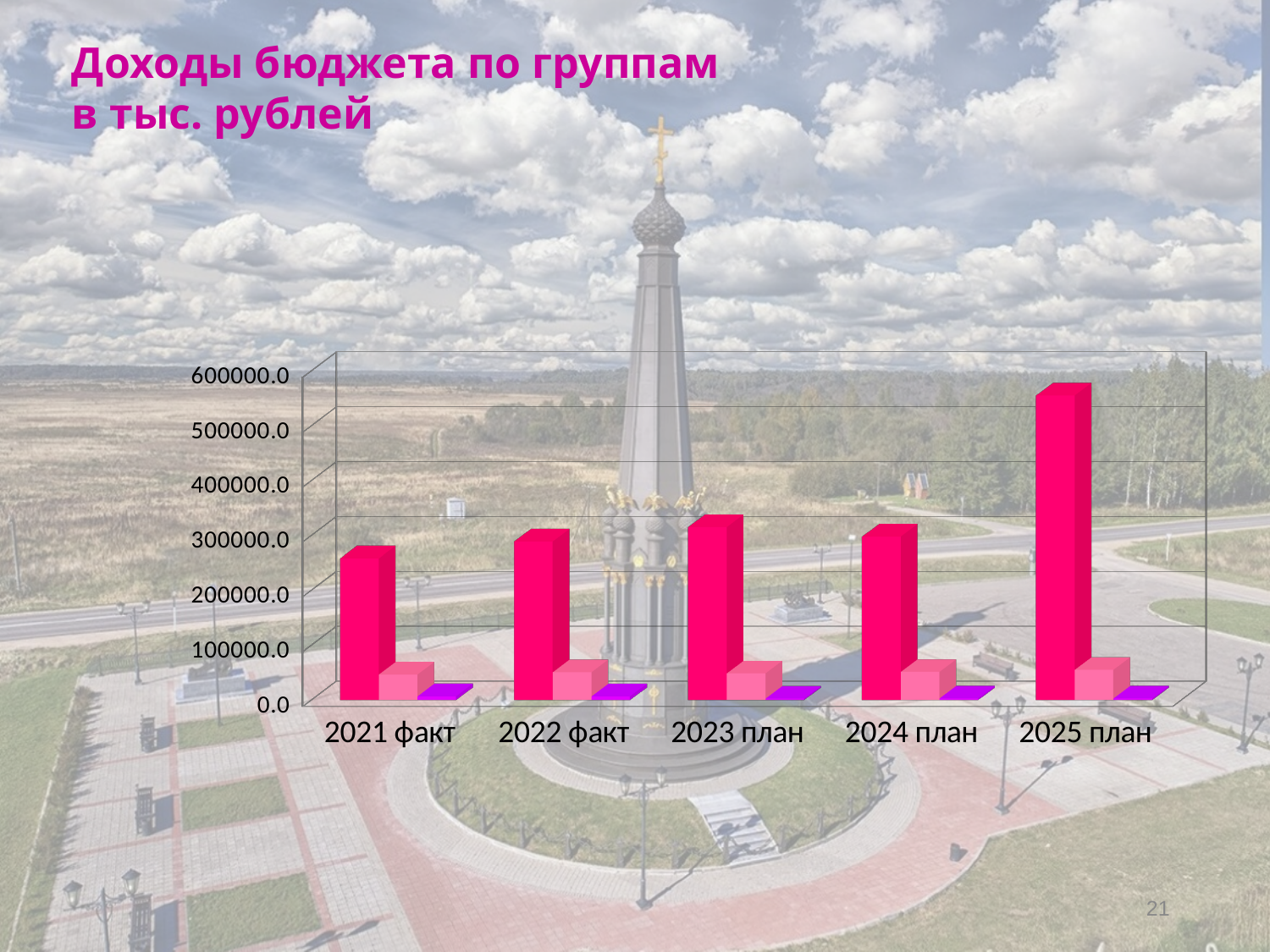
Which category has the tallest bar in the chart? 2025 план Is the tallest bar for 2022 факт greater or less than 200000.0? greater Among the tallest (magenta) bars, which category has the lowest value? 2021 факт What kind of chart is shown on the slide? bar chart Which is larger: the tallest bar for 2025 план or the tallest bar for 2023 план? 2025 план What is the title of the chart on the slide? Доходы бюджета по группам в тыс. рублей How many categories are shown on the x axis of the chart? 5 Is the tallest bar for 2024 план greater or less than 400000.0? less What is the highest value shown on the vertical axis of the chart? 600000.0 Is the tallest bar for 2021 факт greater or less than 300000.0? less How many bars are plotted for each category in the chart? 3